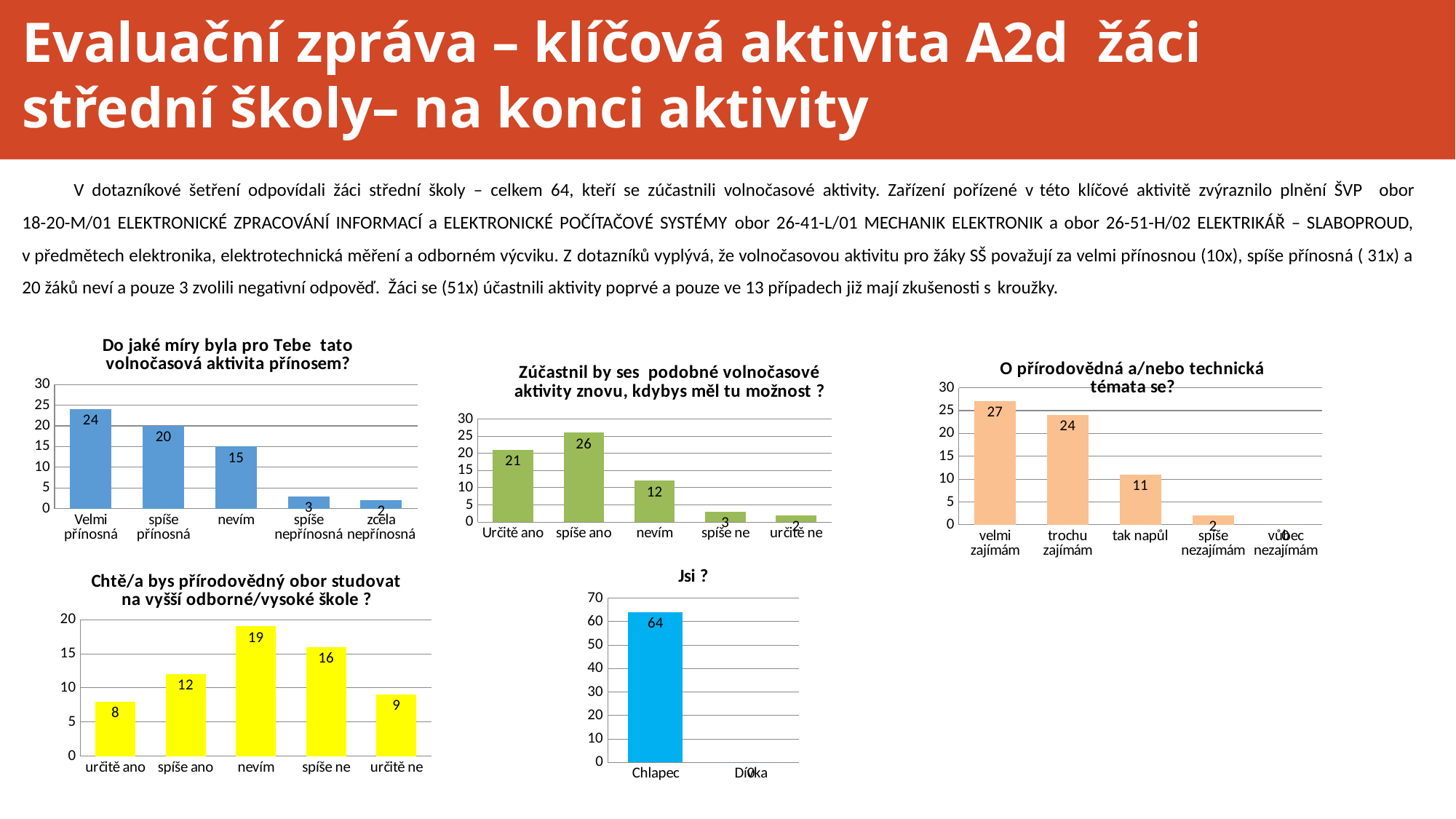
In the chart 'Do jaké míry byla pro Tebe tato volnočasová aktivita přínosem?', what is the value for 'Velmi přínosná'? 24 In the chart 'Zúčastnil by ses podobné volnočasové aktivity znovu, kdybys měl tu možnost ?', which category has the highest value? spíše ano In the chart 'O přírodovědná a/nebo technická témata se?', how many categories are shown on the x axis? 5 In the chart 'Do jaké míry byla pro Tebe tato volnočasová aktivita přínosem?', which category has the lowest value? zcela nepřínosná In the chart 'O přírodovědná a/nebo technická témata se?', which is larger: 'velmi zajímám' or 'trochu zajímám'? velmi zajímám In the chart 'Zúčastnil by ses podobné volnočasové aktivity znovu, kdybys měl tu možnost ?', what is the difference between 'spíše ano' and 'Určitě ano'? 5 What type of chart is 'Jsi ?'? bar chart In the chart 'Jsi ?', what is the value for 'Chlapec'? 64 In the chart 'Chtě/a bys přírodovědný obor studovat na vyšší odborné/vysoké škole ?', what is the value for 'spíše ne'? 16 What colour are the bars in the chart 'Chtě/a bys přírodovědný obor studovat na vyšší odborné/vysoké škole ?'? yellow In the chart 'Chtě/a bys přírodovědný obor studovat na vyšší odborné/vysoké škole ?', which category has the highest value? nevím In the chart 'O přírodovědná a/nebo technická témata se?', what is the value for 'tak napůl'? 11